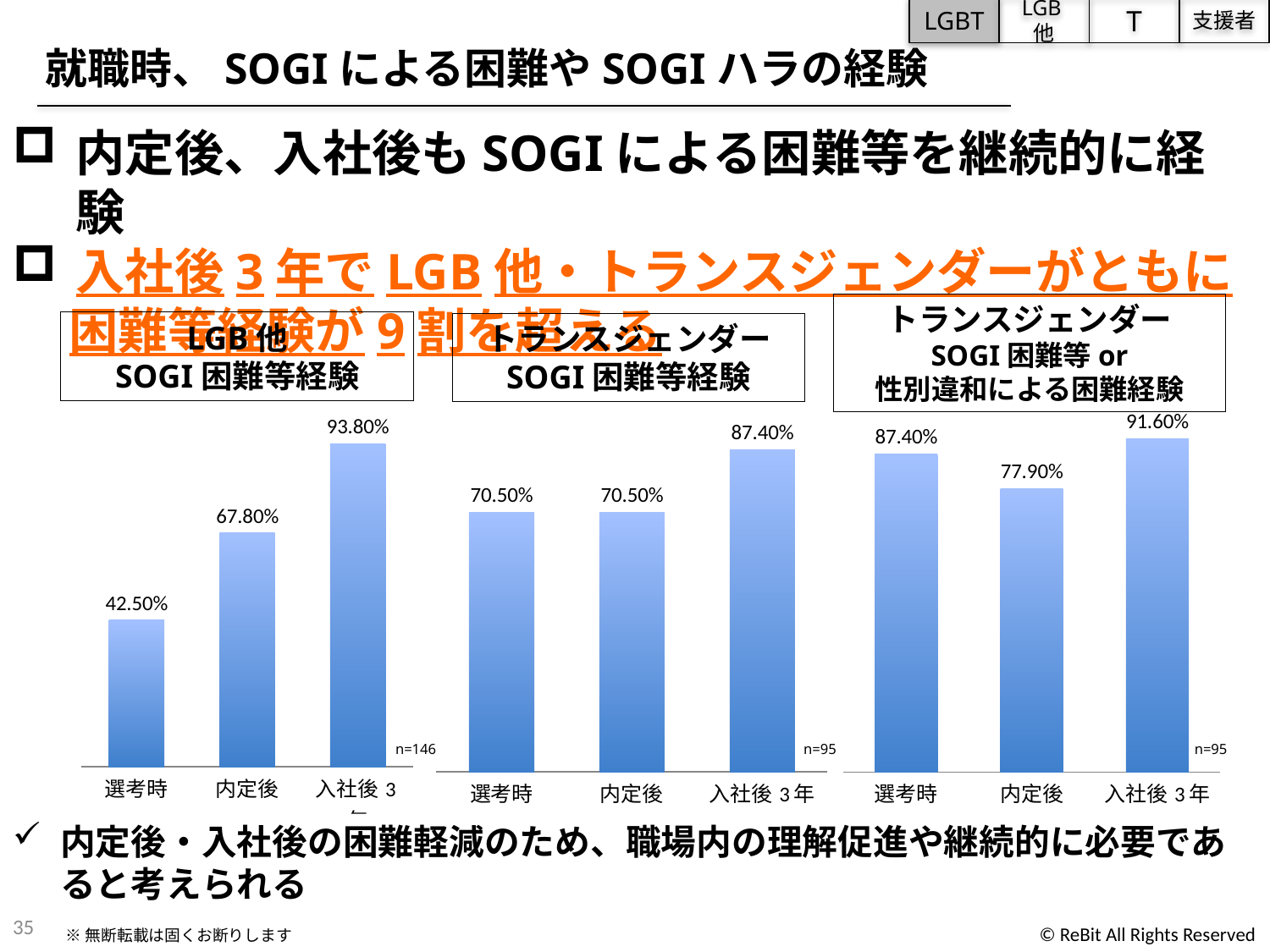
In the left chart (LGB他 SOGI困難等経験), do the values rise or fall from 選考時 to 入社後3年? Rise In the middle chart (トランスジェンダー SOGI困難等経験), what is the difference between the values for 入社後3年 and 内定後? 16.90% How many categories are shown in the middle chart (トランスジェンダー SOGI困難等経験)? 3 In the left chart (LGB他 SOGI困難等経験), what is the difference between the values for 入社後3年 and 選考時? 51.30% In the left chart (LGB他 SOGI困難等経験), which category has the lowest value? 選考時 In the middle chart (トランスジェンダー SOGI困難等経験), what is the value for 内定後? 70.50% In the left chart (LGB他 SOGI困難等経験), what is the value for 選考時? 42.50% In the left chart (LGB他 SOGI困難等経験), what is the value for 入社後3年? 93.80% In the right chart (トランスジェンダー SOGI困難等 or 性別違和による困難経験), what is the value for 内定後? 77.90% In the right chart (トランスジェンダー SOGI困難等 or 性別違和による困難経験), which category has the highest value? 入社後3年 In the right chart (トランスジェンダー SOGI困難等 or 性別違和による困難経験), which is larger, the value for 選考時 or 内定後? 選考時 What type of chart is the left chart (LGB他 SOGI困難等経験)? Bar chart